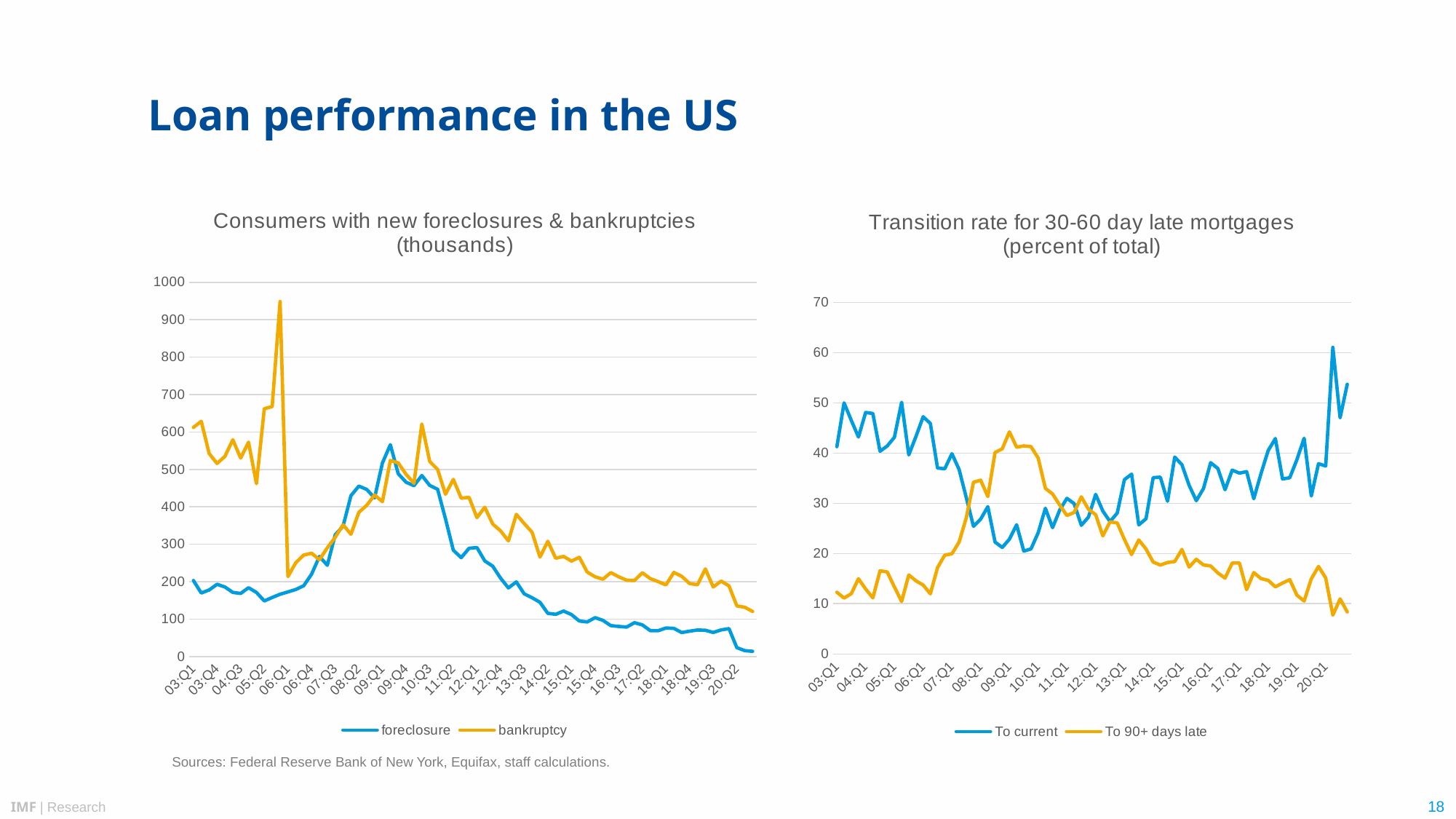
In the right chart, 'Transition rate for 30-60 day late mortgages', does the 'To 90+ days late' series rise or fall from 09:Q1 to 20:Q1? fall What kind of chart is the left chart, 'Consumers with new foreclosures & bankruptcies'? line chart In the left chart, 'Consumers with new foreclosures & bankruptcies', is the peak value of the bankruptcy series greater or less than 900? greater In the left chart, 'Consumers with new foreclosures & bankruptcies', which series reaches the highest value anywhere on the chart? bankruptcy In the left chart, 'Consumers with new foreclosures & bankruptcies', which series is larger at 03:Q1, foreclosure or bankruptcy? bankruptcy What unit is given in the title of the right chart, 'Transition rate for 30-60 day late mortgages'? percent of total In the left chart, 'Consumers with new foreclosures & bankruptcies', does the foreclosure series rise or fall from 09:Q1 to 20:Q2? fall In the left chart, 'Consumers with new foreclosures & bankruptcies', is the foreclosure value at 03:Q1 greater or less than 300? less In the right chart, 'Transition rate for 30-60 day late mortgages', is the 'To current' value at 03:Q1 greater or less than 30? greater How many series does the legend of the right chart, 'Transition rate for 30-60 day late mortgages', list? 2 In the right chart, 'Transition rate for 30-60 day late mortgages', which series is larger at 09:Q1, 'To current' or 'To 90+ days late'? To 90+ days late